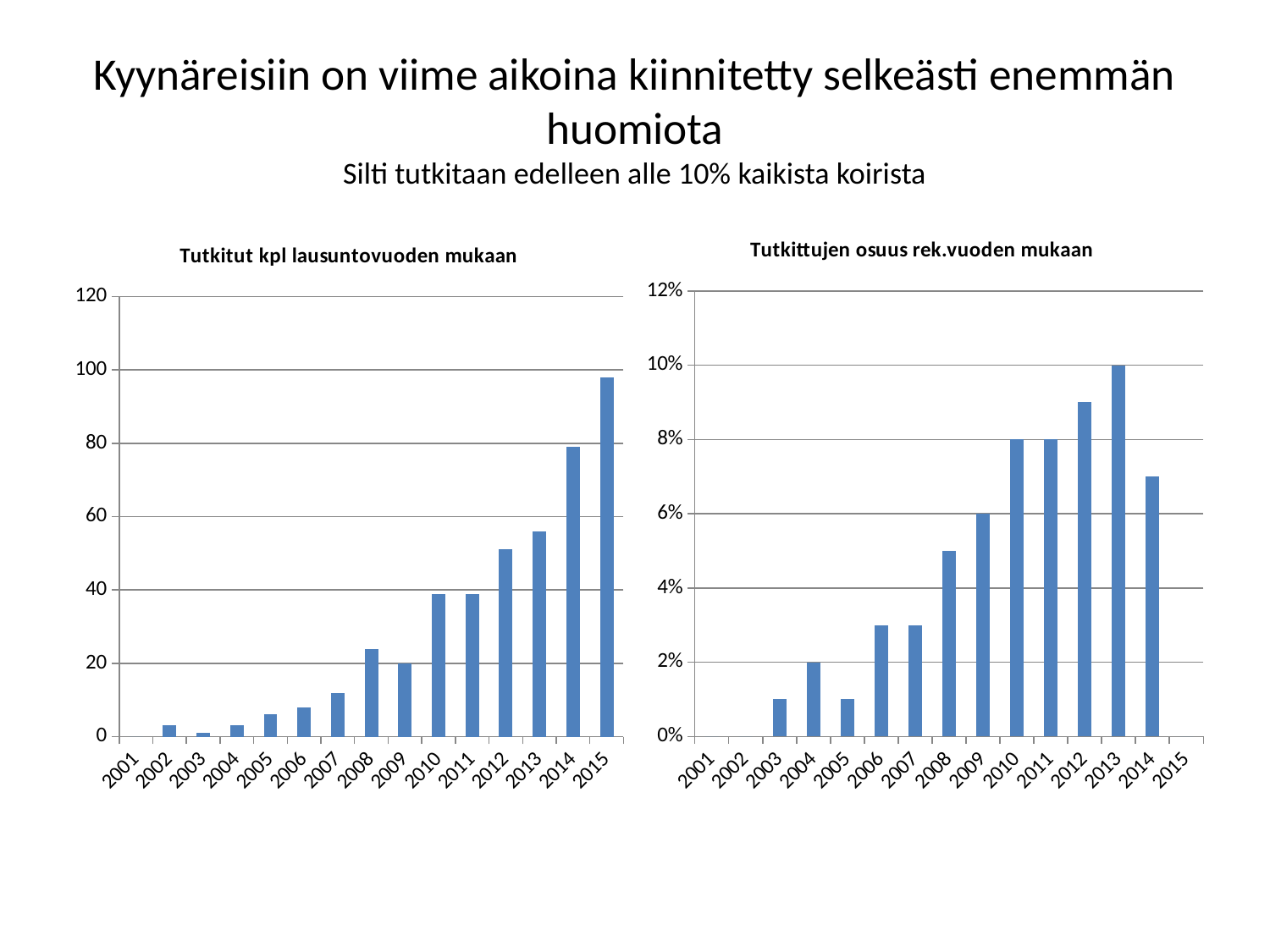
In the left chart 'Tutkitut kpl lausuntovuoden mukaan', is the value for 2013 greater or less than 60? less In the left chart 'Tutkitut kpl lausuntovuoden mukaan', which is larger, the value for 2008 or the value for 2009? 2008 What kind of chart is the left chart, 'Tutkitut kpl lausuntovuoden mukaan'? bar chart In the right chart 'Tutkittujen osuus rek.vuoden mukaan', which year has the highest value? 2013 In the left chart 'Tutkitut kpl lausuntovuoden mukaan', which year has the highest value? 2015 In the right chart 'Tutkittujen osuus rek.vuoden mukaan', what is the value for 2013? 10% In the left chart 'Tutkitut kpl lausuntovuoden mukaan', is the value for 2015 greater or less than 80? greater In the right chart 'Tutkittujen osuus rek.vuoden mukaan', what is the value for 2010? 8% In the left chart 'Tutkitut kpl lausuntovuoden mukaan', do the values generally rise or fall from 2001 to 2015? rise In the left chart 'Tutkitut kpl lausuntovuoden mukaan', is the value for 2012 greater or less than 40? greater How many years are shown on the x axis of the left chart 'Tutkitut kpl lausuntovuoden mukaan'? 15